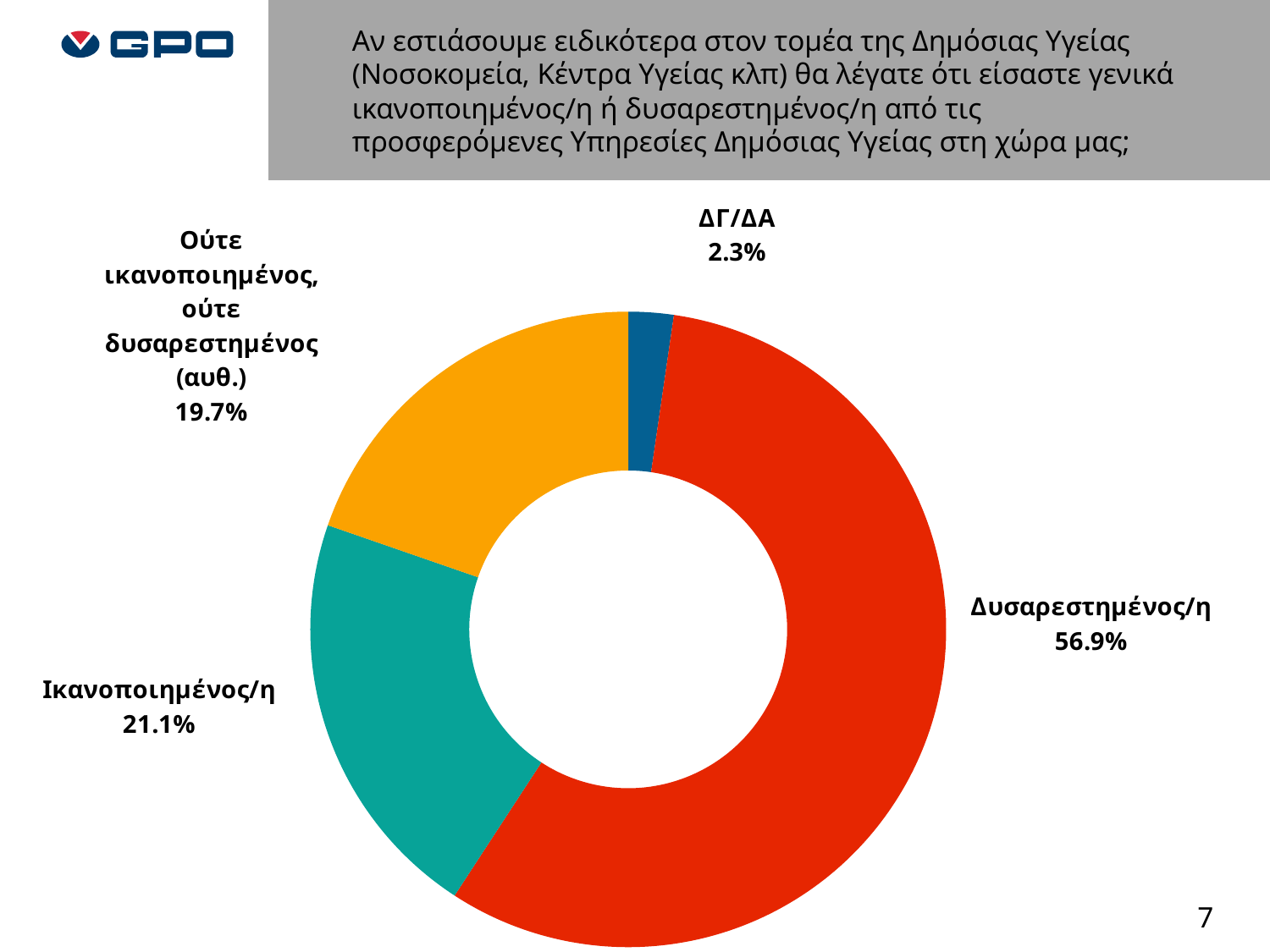
What percentage of respondents answered Δυσαρεστημένος/η? 56.9% Which category has the largest share of the pie? Δυσαρεστημένος/η What is the difference in percentage points between Δυσαρεστημένος/η and Ικανοποιημένος/η? 35.8 What colour is the Δυσαρεστημένος/η slice? Red How many categories are shown in the chart? 4 What percentage is shown for Ούτε ικανοποιημένος, ούτε δυσαρεστημένος (αυθ.)? 19.7% What is the value shown for the ΔΓ/ΔΑ slice? 2.3% Which category has the smallest share of the pie? ΔΓ/ΔΑ Which is larger: Ικανοποιημένος/η or Ούτε ικανοποιημένος, ούτε δυσαρεστημένος (αυθ.)? Ικανοποιημένος/η What colour is the ΔΓ/ΔΑ slice? Dark blue What percentage of respondents answered Ικανοποιημένος/η? 21.1% What kind of chart is shown on the slide? Pie chart (doughnut)